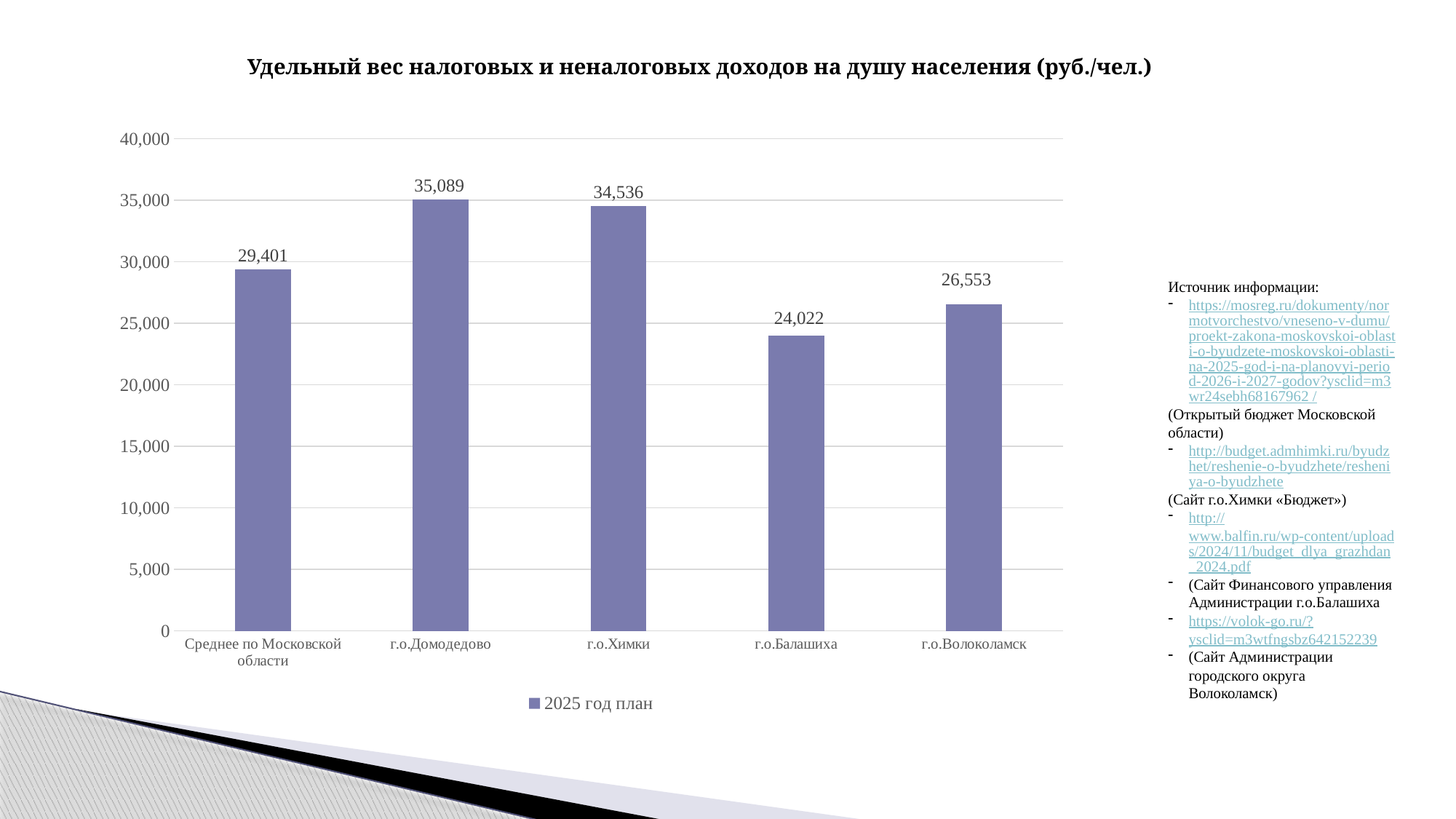
How many categories are shown on the x axis? 5 Is the value for г.о.Химки greater or less than 30,000? greater What is the difference between the values for Среднее по Московской области and г.о.Балашиха? 5,379 What series does the legend list? 2025 год план Which is larger, the value for г.о.Волоколамск or the value for г.о.Балашиха? г.о.Волоколамск What is the difference between the values for г.о.Домодедово and г.о.Химки? 553 What kind of chart is shown on the slide? bar chart What is the value for г.о.Домодедово? 35,089 What is the value for г.о.Балашиха? 24,022 Which category has the highest value? г.о.Домодедово What is the value for Среднее по Московской области? 29,401 Which category has the lowest value? г.о.Балашиха